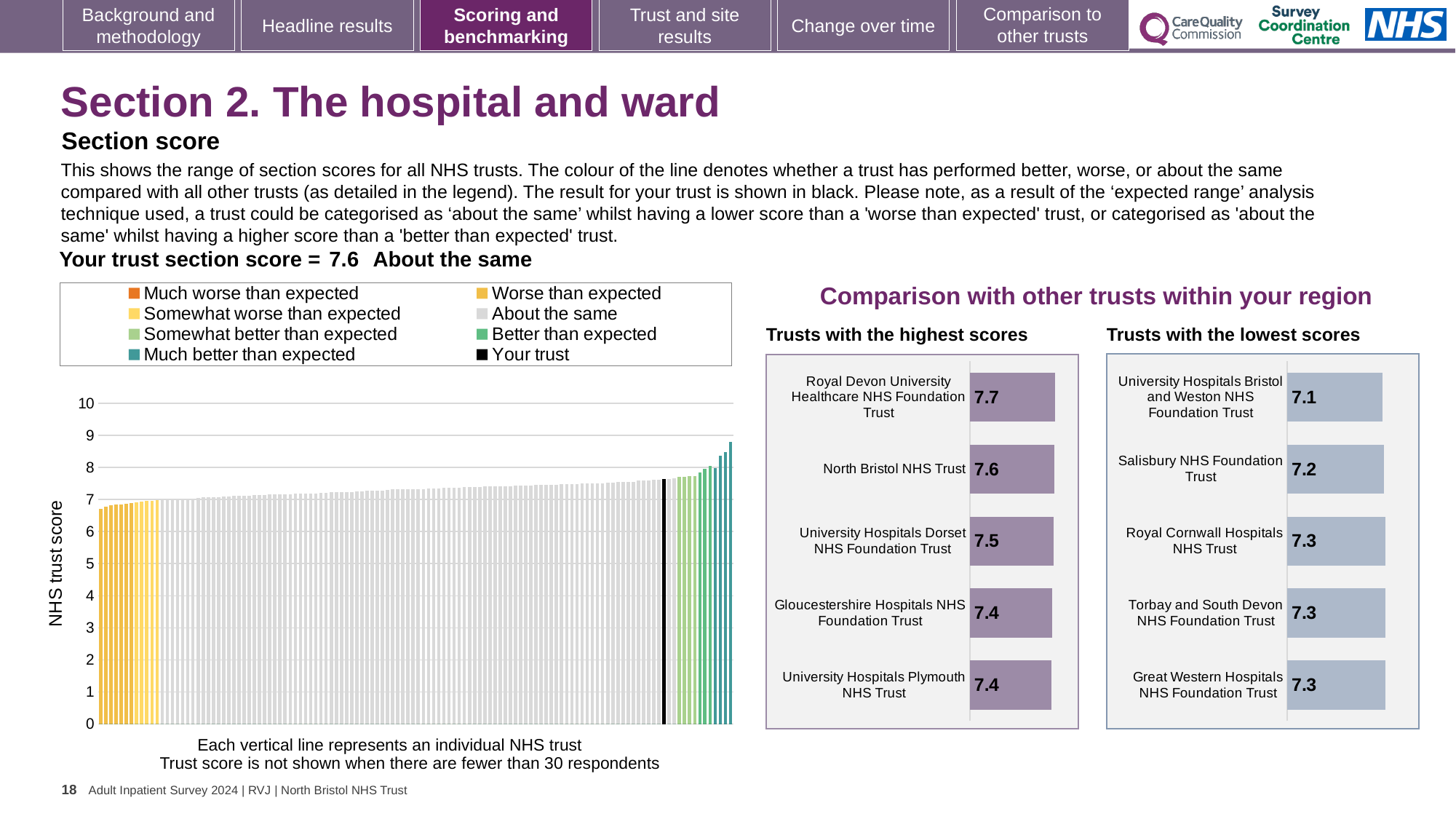
In the 'Trusts with the highest scores' chart, which trust has the highest score? Royal Devon University Healthcare NHS Foundation Trust In the 'Trusts with the lowest scores' chart, what is the score for Salisbury NHS Foundation Trust? 7.2 In the 'Trusts with the highest scores' chart, what is the score for Royal Devon University Healthcare NHS Foundation Trust? 7.7 In the 'Trusts with the highest scores' chart, what is the score for University Hospitals Dorset NHS Foundation Trust? 7.5 How many trusts are listed in the 'Trusts with the lowest scores' chart? 5 What kind of chart is the NHS trust score chart on the left of the slide? Bar chart In the NHS trust score chart on the left, is the value of the tallest bar greater or less than 8? greater In the 'Trusts with the lowest scores' chart, which trust has the lowest score? University Hospitals Bristol and Weston NHS Foundation Trust In the 'Trusts with the highest scores' chart, which has the larger score: North Bristol NHS Trust or Gloucestershire Hospitals NHS Foundation Trust? North Bristol NHS Trust In the NHS trust score chart on the left, do the bar values rise or fall from left to right? Rise What is the difference between the score for Royal Devon University Healthcare NHS Foundation Trust in the 'Trusts with the highest scores' chart and the score for University Hospitals Bristol and Weston NHS Foundation Trust in the 'Trusts with the lowest scores' chart? 0.6 How many entries does the legend of the NHS trust score chart on the left list? 8